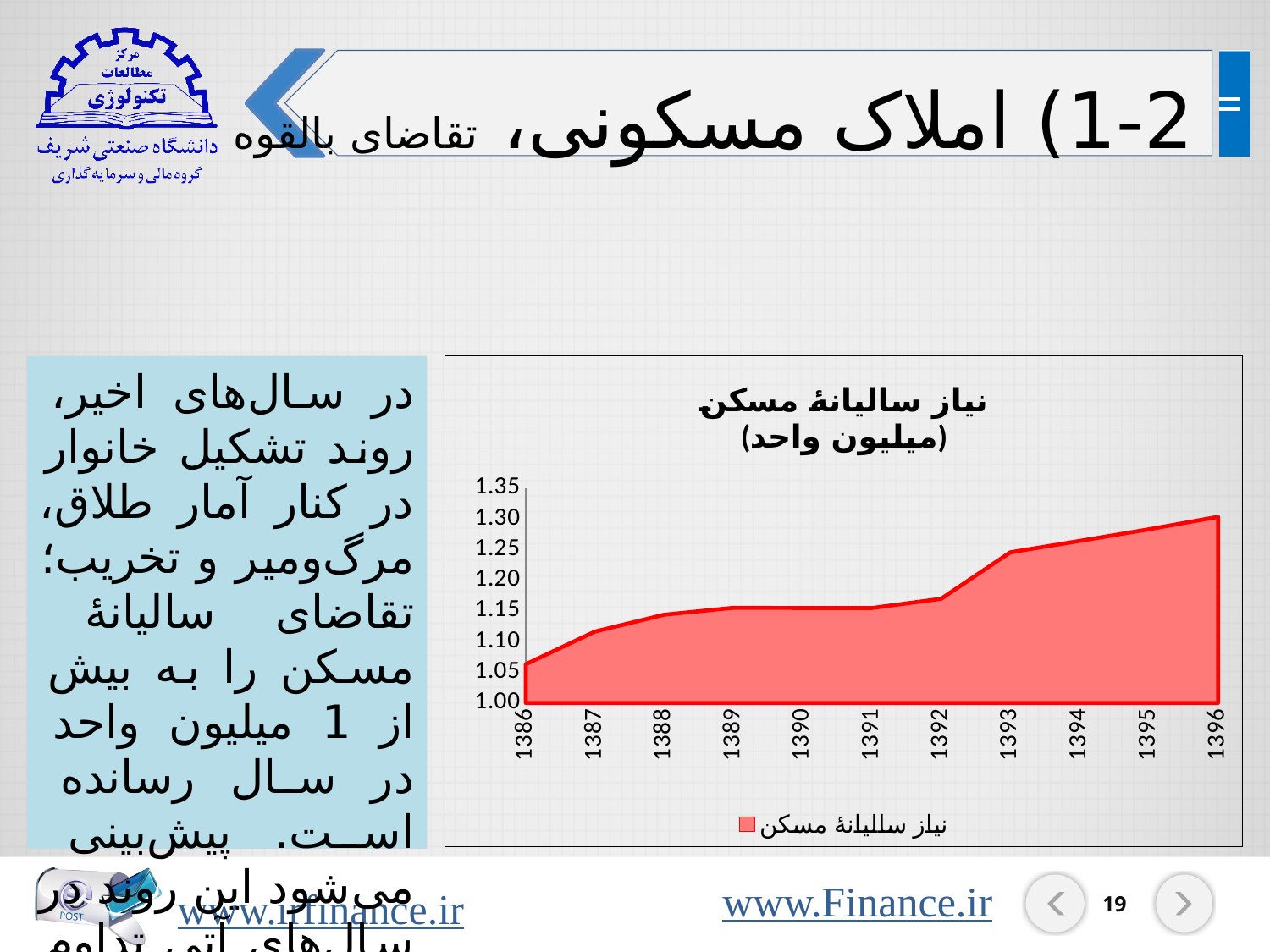
How many series does the chart legend list? 1 Which year has the larger value, 1390 or 1393? 1393 Is the value for 1389 greater or less than 1.20? less What kind of chart is shown on the slide? area chart What is the title of the chart? نیاز سالیانۀ مسکن (میلیون واحد) Is the value for 1393 greater or less than 1.20? greater Do the values in the chart generally rise or fall from 1386 to 1396? rise How many years are plotted along the x axis of the chart? 11 Which year has the lowest value in the chart? 1386 Is the value for 1396 greater or less than 1.25? greater Which year has the highest value in the chart? 1396